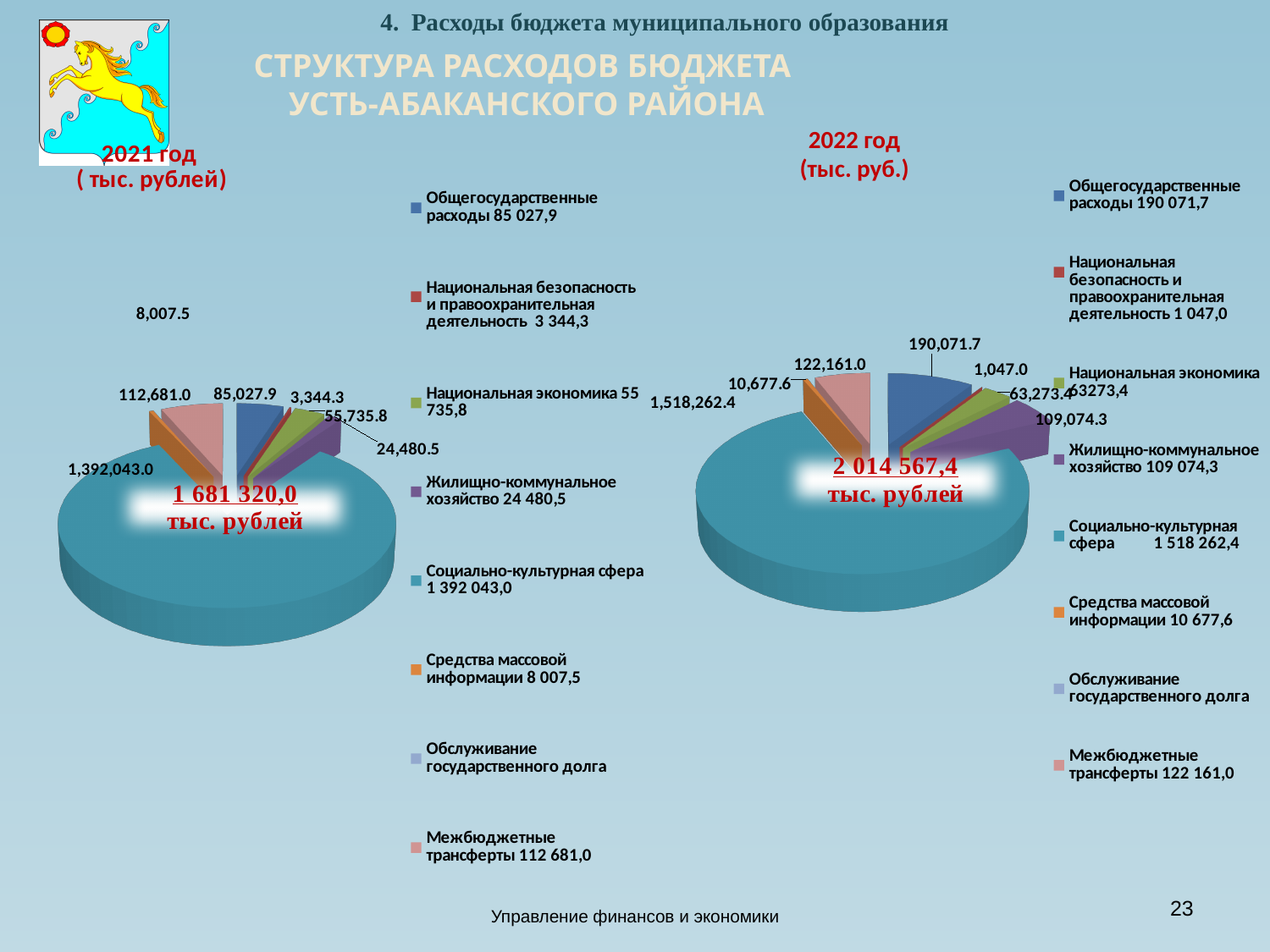
How many entries does the legend of the 2022 chart list? 8 In the 2022 chart, which category has the largest slice? Социально-культурная сфера In the 2021 chart, which labelled category has the smallest value? Национальная безопасность и правоохранительная деятельность In the 2021 chart, which is larger: Межбюджетные трансферты or Общегосударственные расходы? Межбюджетные трансферты In the 2022 chart, which labelled category has the smallest value? Национальная безопасность и правоохранительная деятельность What is the difference between Общегосударственные расходы in the 2022 chart and in the 2021 chart? 105,043.8 In the 2021 chart, what is the value for Межбюджетные трансферты? 112,681.0 In the 2021 chart, what is the value for Социально-культурная сфера? 1,392,043.0 In the 2022 chart, what is the value for Общегосударственные расходы? 190,071.7 In the 2022 chart, what is the value for Средства массовой информации? 10,677.6 What kind of chart is used for the 2021 budget expenditure structure? pie chart What total is printed on the 2021 chart? 1 681 320,0 тыс. рублей